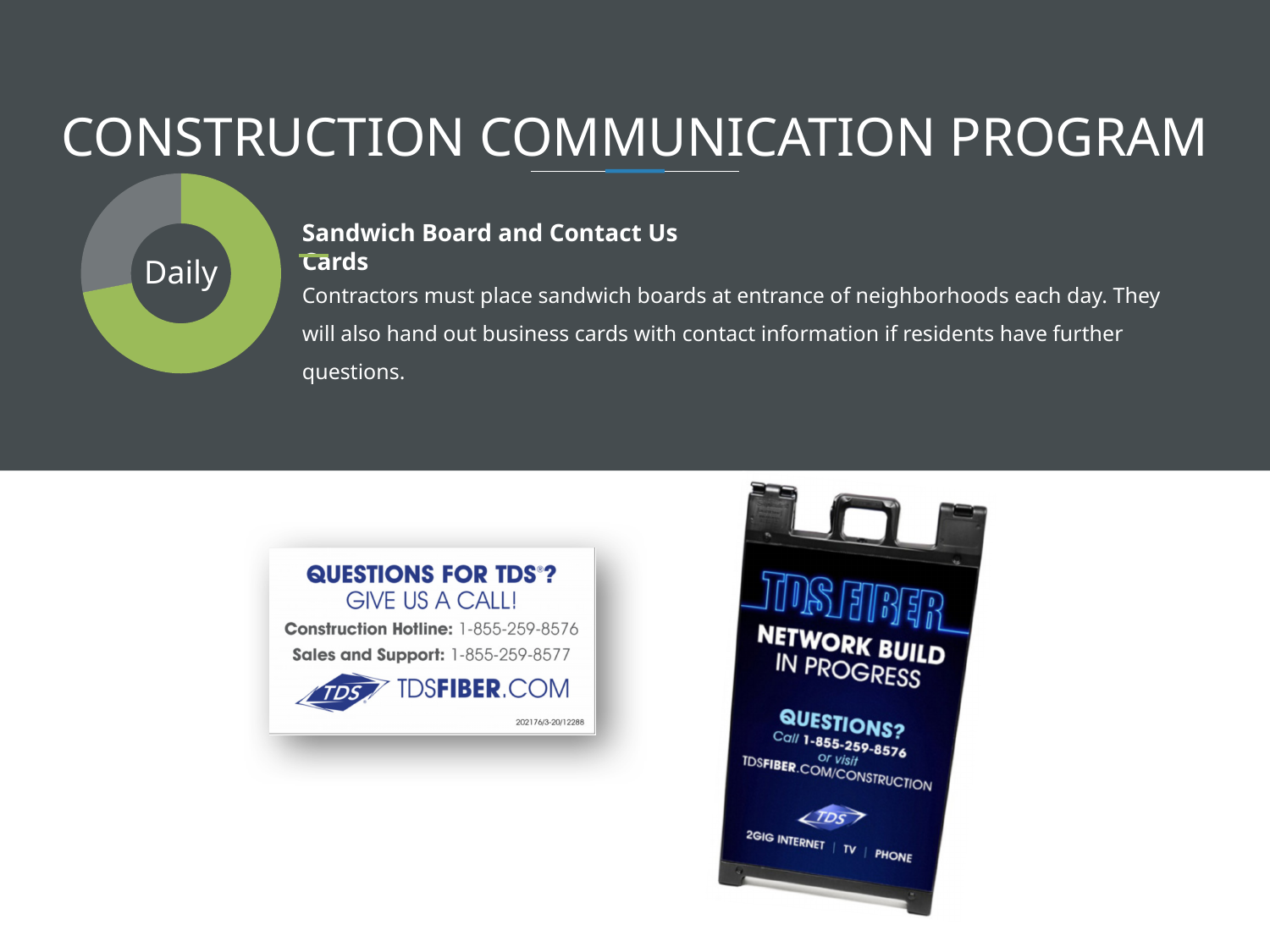
What two colours are used for the slices of the doughnut chart? green and gray What kind of chart is shown on the slide? doughnut chart What word is printed in the centre of the doughnut chart? Daily How many slices does the doughnut chart have? 2 Which slice of the doughnut chart is larger, the green one or the gray one? green Which colour slice is the smallest in the doughnut chart? gray